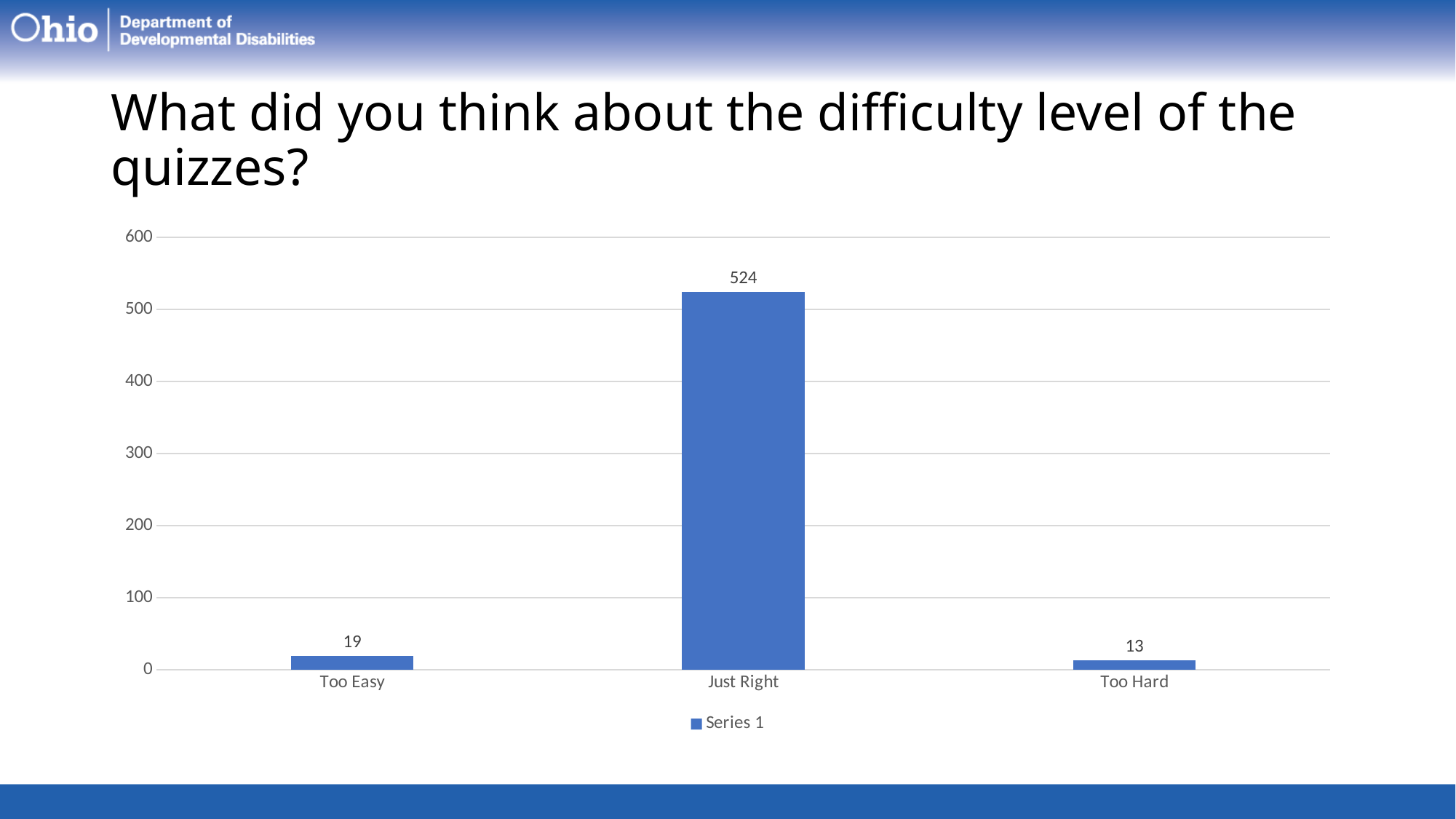
What kind of chart is shown on the slide? bar chart What is the difference between the values for Too Easy and Too Hard? 6 Which category has the highest value? Just Right Is the value for Just Right greater or less than 500? greater What series name does the legend show? Series 1 Which is larger, the value for Too Easy or the value for Too Hard? Too Easy What is the value for Too Hard? 13 Which category has the lowest value? Too Hard What is the value for Too Easy? 19 What is the value for Just Right? 524 What is the difference between the values for Just Right and Too Easy? 505 How many categories are shown on the x axis? 3